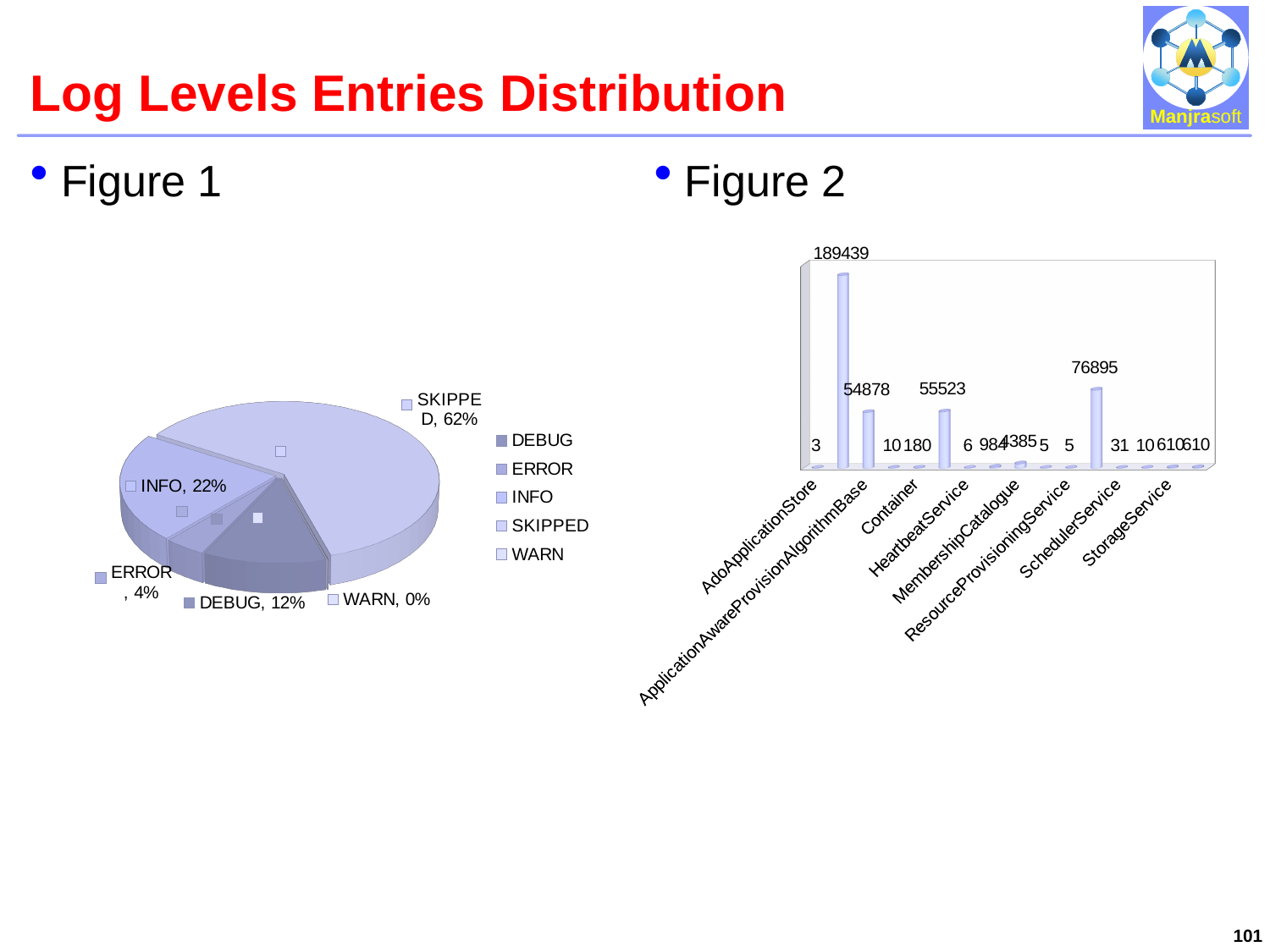
In Figure 2, which is larger, the bar labelled 55523 or the bar labelled 54878? 55523 In Figure 1, how many entries does the legend list? 5 In Figure 2, what is the highest value labelled on any bar? 189439 In Figure 1, which log level has the smallest slice of the pie? WARN In Figure 1, by how many percentage points does SKIPPED exceed INFO? 40 percentage points In Figure 1, which log level has the largest slice of the pie? SKIPPED In Figure 1, what percentage is shown for ERROR? 4% In Figure 2, what kind of chart is shown? Bar chart In Figure 1, what share of the pie does SKIPPED account for? 62% In Figure 1, what percentage is shown for DEBUG? 12% In Figure 1, what kind of chart is shown? Pie chart In Figure 1, what percentage is shown for INFO? 22%